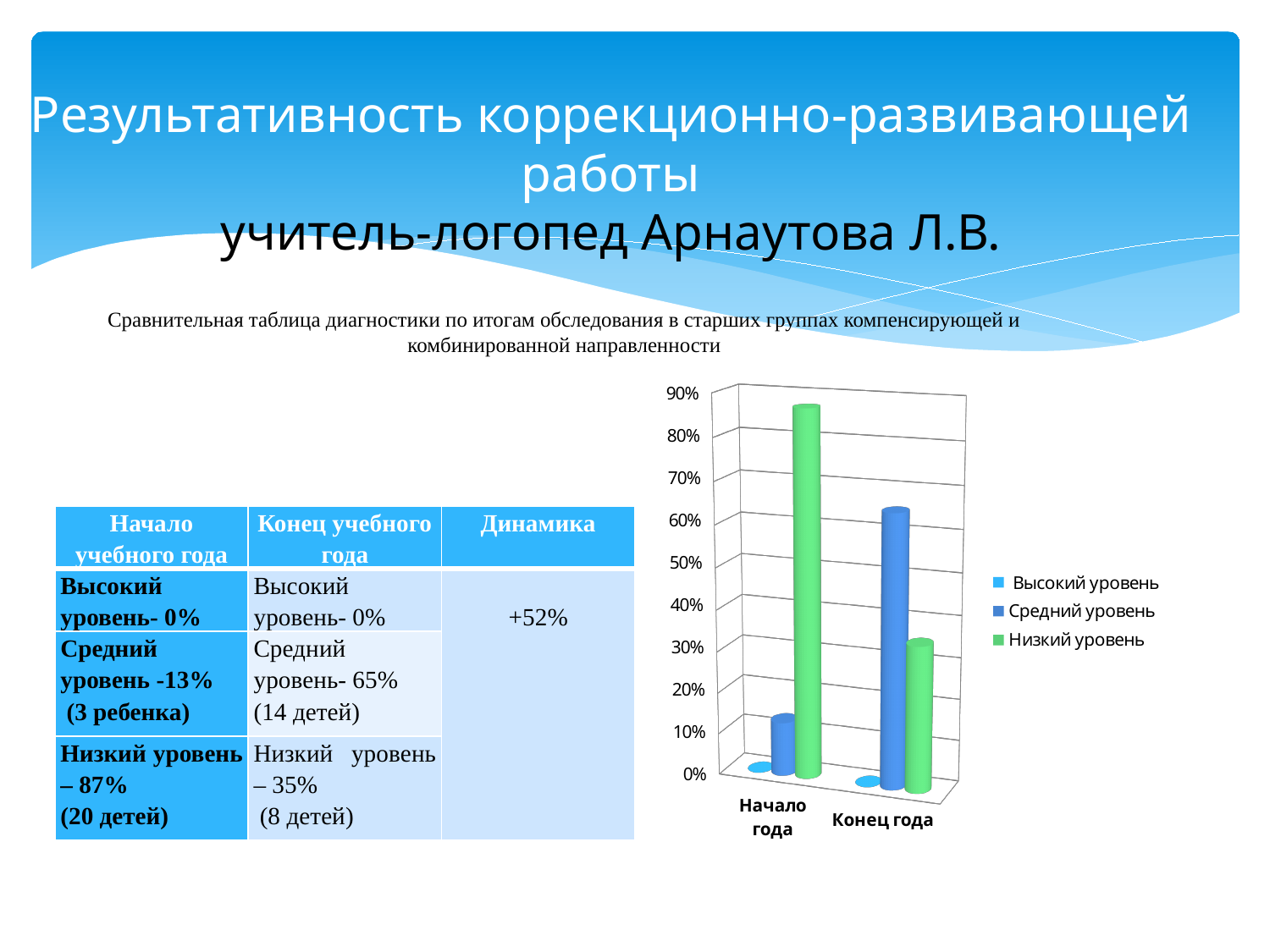
How many series does the chart legend list? 3 Is the value for Средний уровень at Начало года greater or less than 20%? less Is the value for Низкий уровень at Начало года greater or less than 80%? greater What kind of chart is shown on the slide? bar chart Does the Средний уровень series rise or fall from Начало года to Конец года? rise Is the value for Низкий уровень at Конец года greater or less than 50%? less How many categories are shown on the x axis of the chart? 2 Which series has the tallest bar for Начало года? Низкий уровень Which series has the lowest bar for Начало года? Высокий уровень Which series has the tallest bar for Конец года? Средний уровень Which is larger: Низкий уровень at Начало года or Низкий уровень at Конец года? Начало года